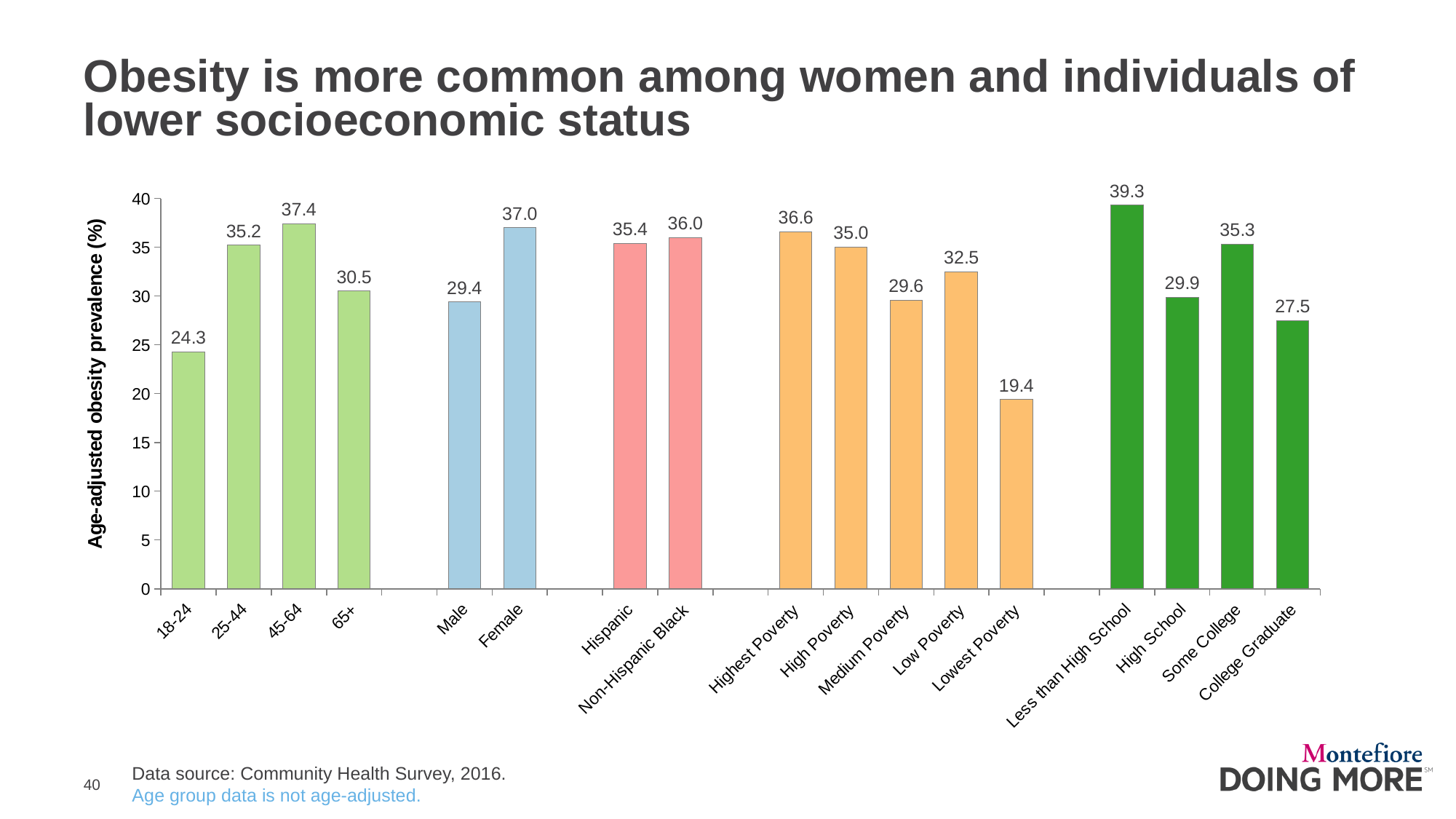
What is the difference in obesity prevalence between Female and Male? 7.6 Which has a higher obesity prevalence, the 45-64 age group or the 65+ age group? 45-64 Is the value for High School greater or less than 30? less What is the age-adjusted obesity prevalence for College Graduate? 27.5 What is the label of the vertical axis? Age-adjusted obesity prevalence (%) What type of chart is shown on the slide? bar chart Which category has the highest obesity prevalence on the chart? Less than High School Which category has the lowest obesity prevalence on the chart? Lowest Poverty What is the age-adjusted obesity prevalence for Female? 37.0 What is the age-adjusted obesity prevalence for Lowest Poverty? 19.4 How many bars are plotted on the chart? 17 What is the difference in obesity prevalence between Highest Poverty and Lowest Poverty? 17.2